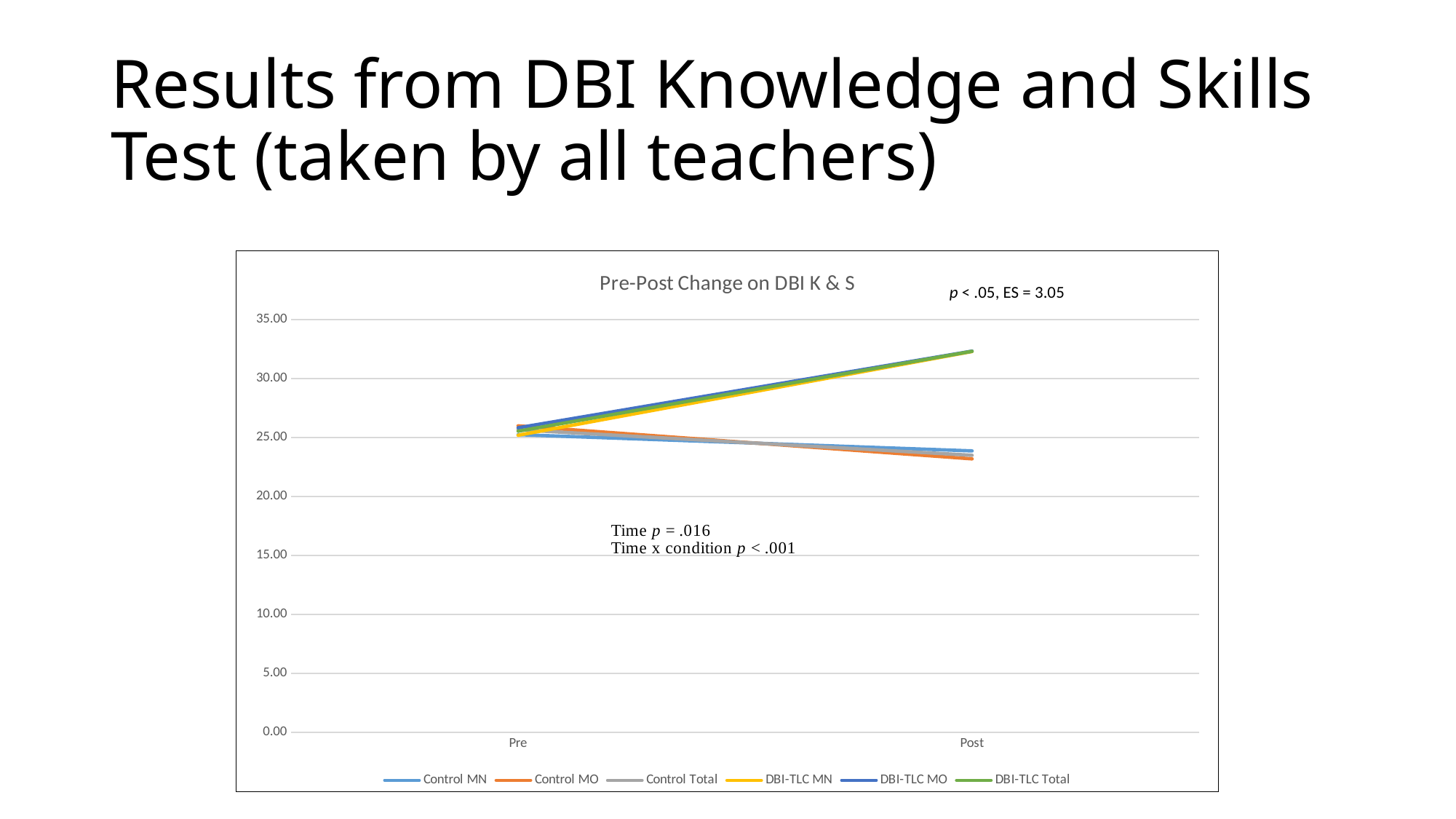
What effect size (ES) is reported in the annotation at the top right of the chart? 3.05 Does the Control MO line rise or fall from Pre to Post? fall Is the value for Control MO at Post greater or less than 25.00? less How many series does the legend list? 6 How many time points are shown on the x axis? 2 Does the Control MN line rise or fall from Pre to Post? fall What is the title of the chart? Pre-Post Change on DBI K & S Is the value for DBI-TLC MN at Post greater or less than 35.00? less Does the DBI-TLC Total line rise or fall from Pre to Post? rise At Post, which is larger: DBI-TLC Total or Control Total? DBI-TLC Total What kind of chart is shown on the slide? line chart Is the value for DBI-TLC Total at Post greater or less than 30.00? greater